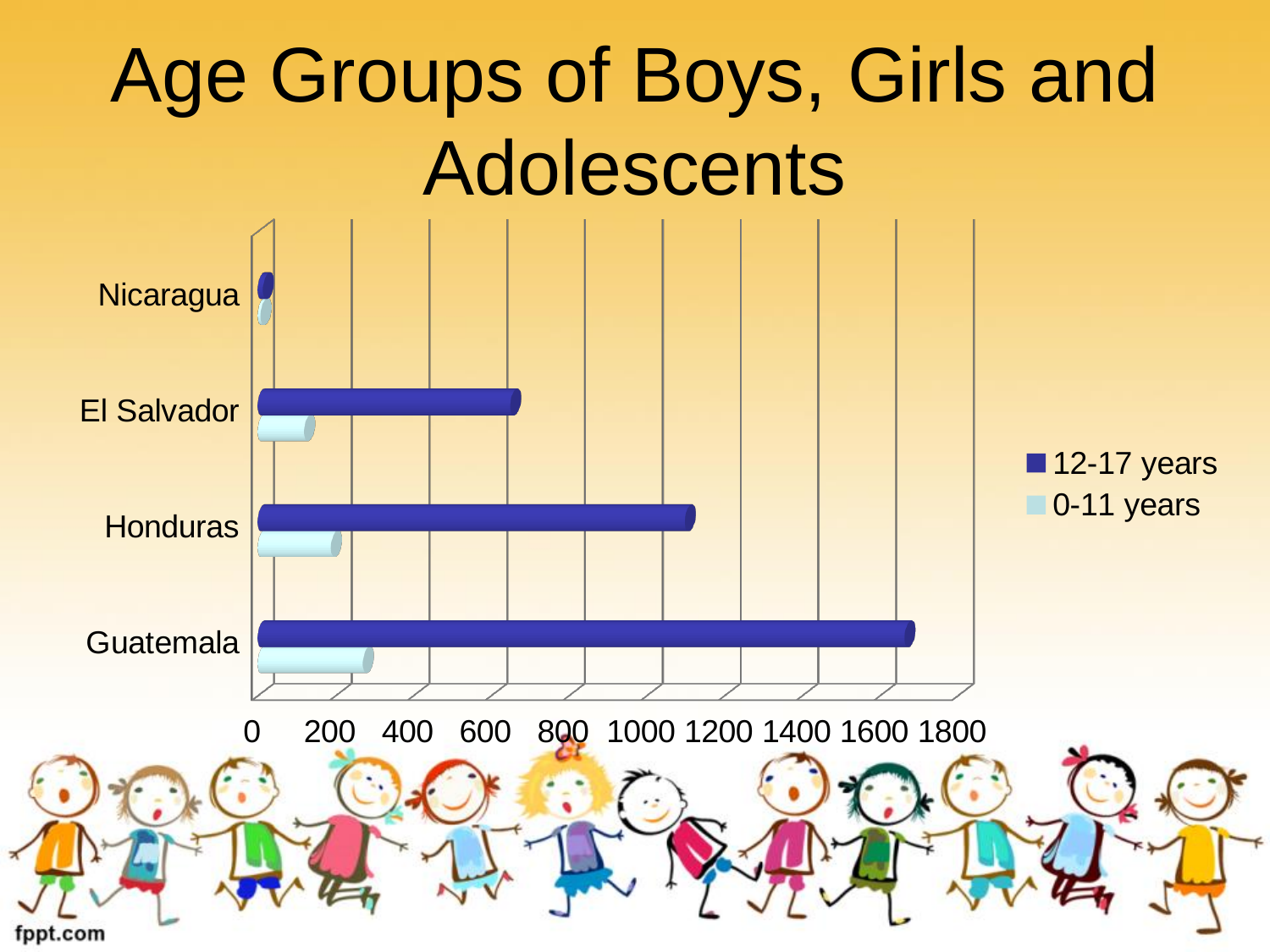
Is the value for Nicaragua in the 12-17 years series greater or less than 200? less What is the title of the chart on the slide? Age Groups of Boys, Girls and Adolescents Which is larger for 12-17 years: Honduras or El Salvador? Honduras Which country has the highest value for 0-11 years? Guatemala Is the value for Guatemala in the 12-17 years series greater or less than 1600? greater How many countries are shown on the chart? 4 Is the value for Honduras in the 12-17 years series greater or less than 1000? greater What kind of chart is shown on the slide? bar chart Which country has the lowest value for 12-17 years? Nicaragua How many series does the legend list? 2 Which country has the highest value for 12-17 years? Guatemala